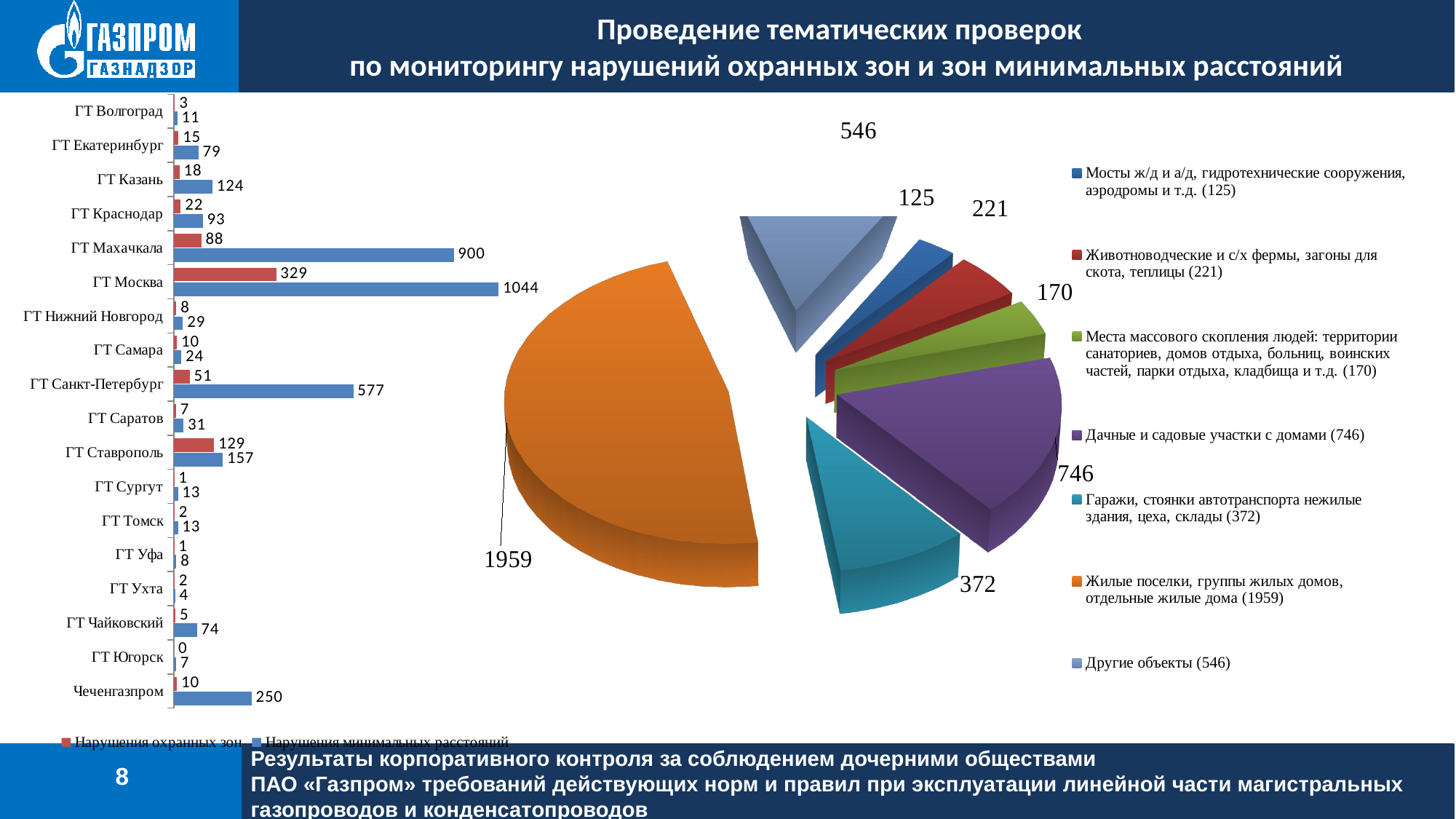
In the bar chart on the left, what is the value of Нарушения охранных зон for ГТ Ставрополь? 129 How many slices does the pie chart on the right have? 7 In the bar chart on the left, which has the larger Нарушения минимальных расстояний value, ГТ Казань or ГТ Краснодар? ГТ Казань In the bar chart on the left, what is the value of Нарушения минимальных расстояний for ГТ Москва? 1044 In the bar chart on the left, which category has the highest value for Нарушения минимальных расстояний? ГТ Москва In the pie chart on the right, which category has the largest slice? Жилые поселки, группы жилых домов, отдельные жилые дома In the bar chart on the left, what is the difference between the Нарушения минимальных расстояний values for ГТ Махачкала and ГТ Санкт-Петербург? 323 In the bar chart on the left, which category has the lowest value for Нарушения охранных зон? ГТ Югорск How many categories are shown in the bar chart on the left? 18 What kind of chart is the chart on the left of the slide? Bar chart How many series does the legend of the bar chart on the left list? 2 In the pie chart on the right, what is the value for Дачные и садовые участки с домами? 746